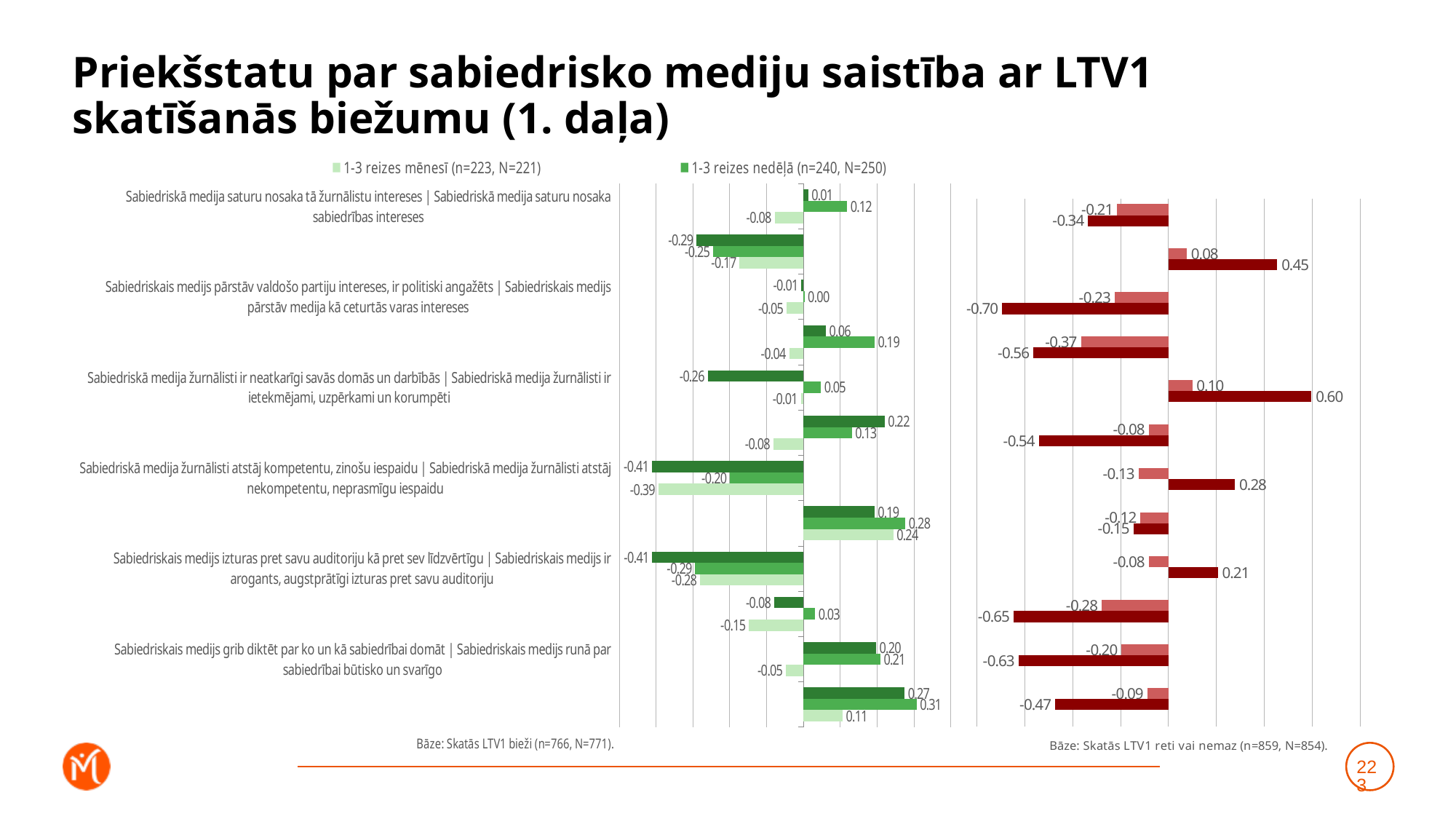
How many category labels are listed down the left side of the left-hand chart? 6 In the right-hand (red) chart, which is larger: the bar labelled 0.60 or the bar labelled 0.45? 0.60 In the right-hand (red) chart, what is the highest value shown? 0.60 What is the base note printed under the left-hand (green) chart? Bāze: Skatās LTV1 bieži (n=766, N=771). How many entries does the legend above the left-hand chart list? 2 In the left-hand (green) chart, what is the lowest value shown? -0.41 What kind of chart is shown on the left side of the slide? bar chart In the right-hand (red) chart, what is the lowest value shown? -0.70 What colour are the bars in the right-hand chart? red In the right-hand (red) chart, what is the difference between the two largest positive values, 0.60 and 0.45? 0.15 In the left-hand (green) chart, what is the highest value shown? 0.31